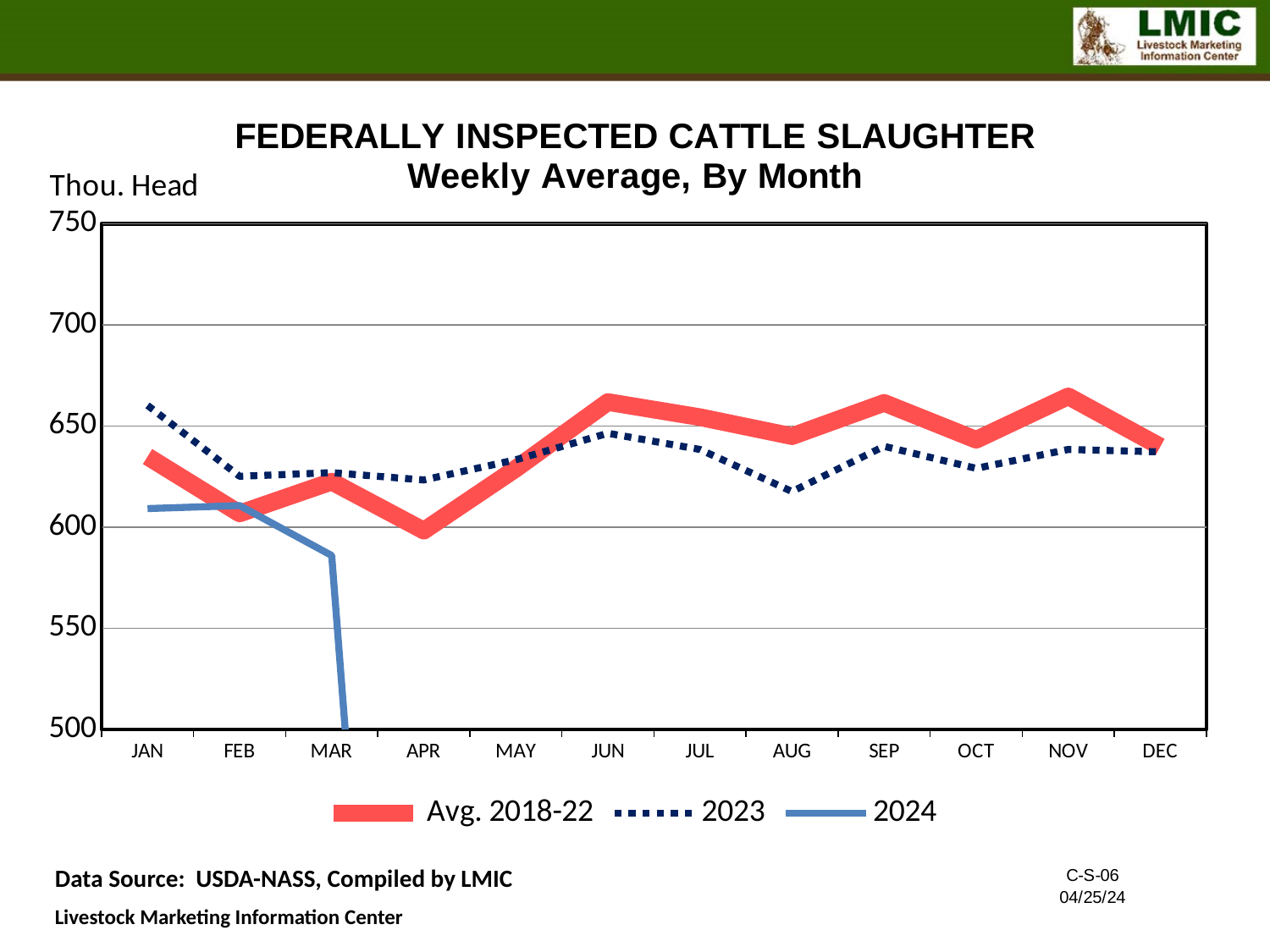
In JUN, which is larger: the Avg. 2018-22 value or the 2023 value? Avg. 2018-22 Which series are listed in the legend? Avg. 2018-22, 2023, 2024 How many series does the legend list? 3 What is the unit label shown on the y axis? Thou. Head In which month is the Avg. 2018-22 series at its lowest? APR How many months are shown along the x axis? 12 What kind of chart is shown on the slide? line chart Is the 2024 value for MAR greater or less than 600? less Does the 2024 series rise or fall from JAN to MAR? fall Is the 2023 value for AUG greater or less than 650? less Is the Avg. 2018-22 value for JUN greater or less than 650? greater In which month is the 2023 series at its highest? JAN